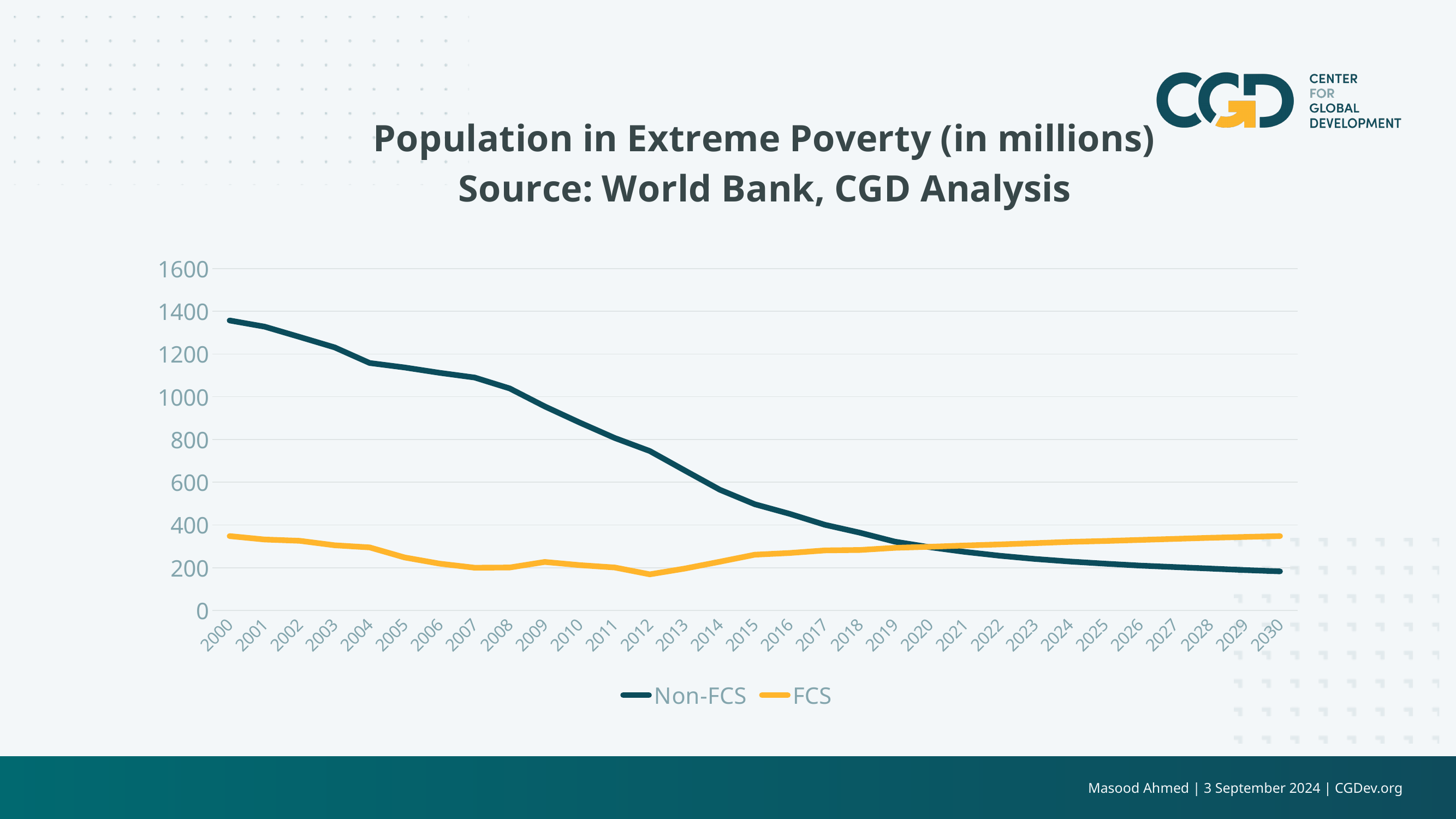
In which year is the Non-FCS value highest? 2000 Is the Non-FCS value for 2000 greater or less than 1200? greater What kind of chart is shown on the slide? line chart Does the Non-FCS line rise or fall from 2000 to 2030? fall Is the Non-FCS value for 2015 greater or less than 800? less In 2030, which series has the higher value, Non-FCS or FCS? FCS How many years are shown along the x axis? 31 Is the FCS value for 2000 greater or less than 600? less In 2000, which series has the higher value, Non-FCS or FCS? Non-FCS Does the FCS line rise or fall between 2012 and 2030? rise How many series does the legend list? 2